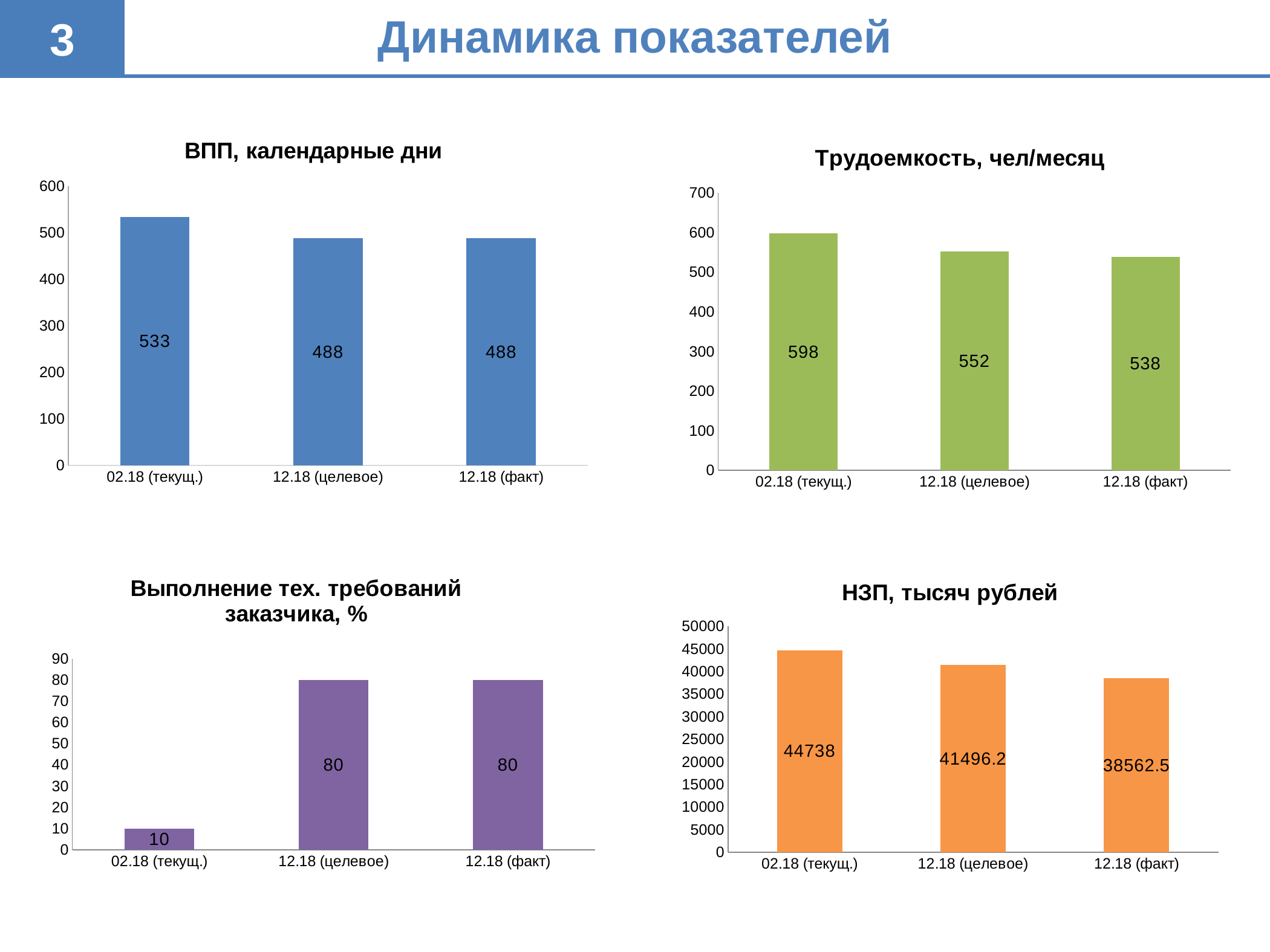
What kind of chart is the chart titled "НЗП, тысяч рублей"? bar chart In the chart titled "Трудоемкость, чел/месяц", which category has the lowest value? 12.18 (факт) In the chart titled "НЗП, тысяч рублей", what is the value for 12.18 (факт)? 38562.5 In the chart titled "НЗП, тысяч рублей", which category has the highest value? 02.18 (текущ.) In the chart titled "НЗП, тысяч рублей", which is larger: the value for 12.18 (целевое) or the value for 12.18 (факт)? 12.18 (целевое) In the chart titled "Выполнение тех. требований заказчика, %", what is the value for 02.18 (текущ.)? 10 In the chart titled "Трудоемкость, чел/месяц", do the values rise or fall from left to right along the x axis? fall In the chart titled "Трудоемкость, чел/месяц", what is the value for 12.18 (целевое)? 552 In the chart titled "Выполнение тех. требований заказчика, %", what is the difference between the value for 12.18 (целевое) and the value for 02.18 (текущ.)? 70 In the chart titled "ВПП, календарные дни", what is the value for 02.18 (текущ.)? 533 How many categories are shown on the x axis of the chart titled "ВПП, календарные дни"? 3 In the chart titled "ВПП, календарные дни", what is the difference between the value for 02.18 (текущ.) and the value for 12.18 (факт)? 45